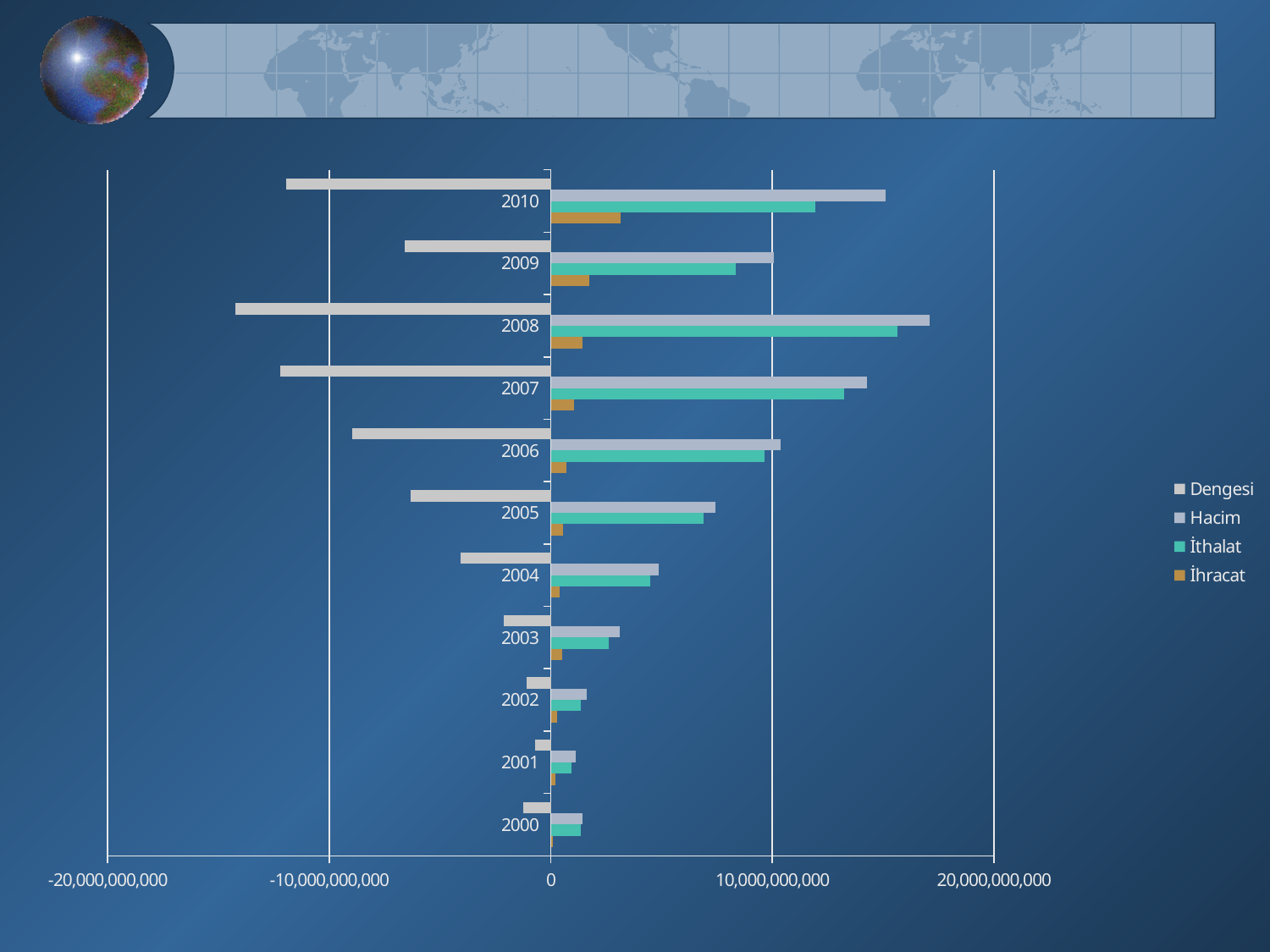
Which year has the larger Hacim value, 2009 or 2010? 2010 Does the Hacim value rise or fall from 2000 to 2008? rise In which year is the Dengesi value the lowest (most negative)? 2008 Is the Hacim value for 2005 greater or less than 10,000,000,000? less In which year is the İhracat bar the longest? 2010 What kind of chart is shown on the slide? bar chart How many years (categories) are shown on the chart? 11 How many series does the legend list? 4 Which series is shown in orange/gold in the legend? İhracat In which year is the Hacim bar the longest? 2008 Is the Dengesi value for 2010 greater or less than -10,000,000,000? less Is the Hacim value for 2008 greater or less than 10,000,000,000? greater